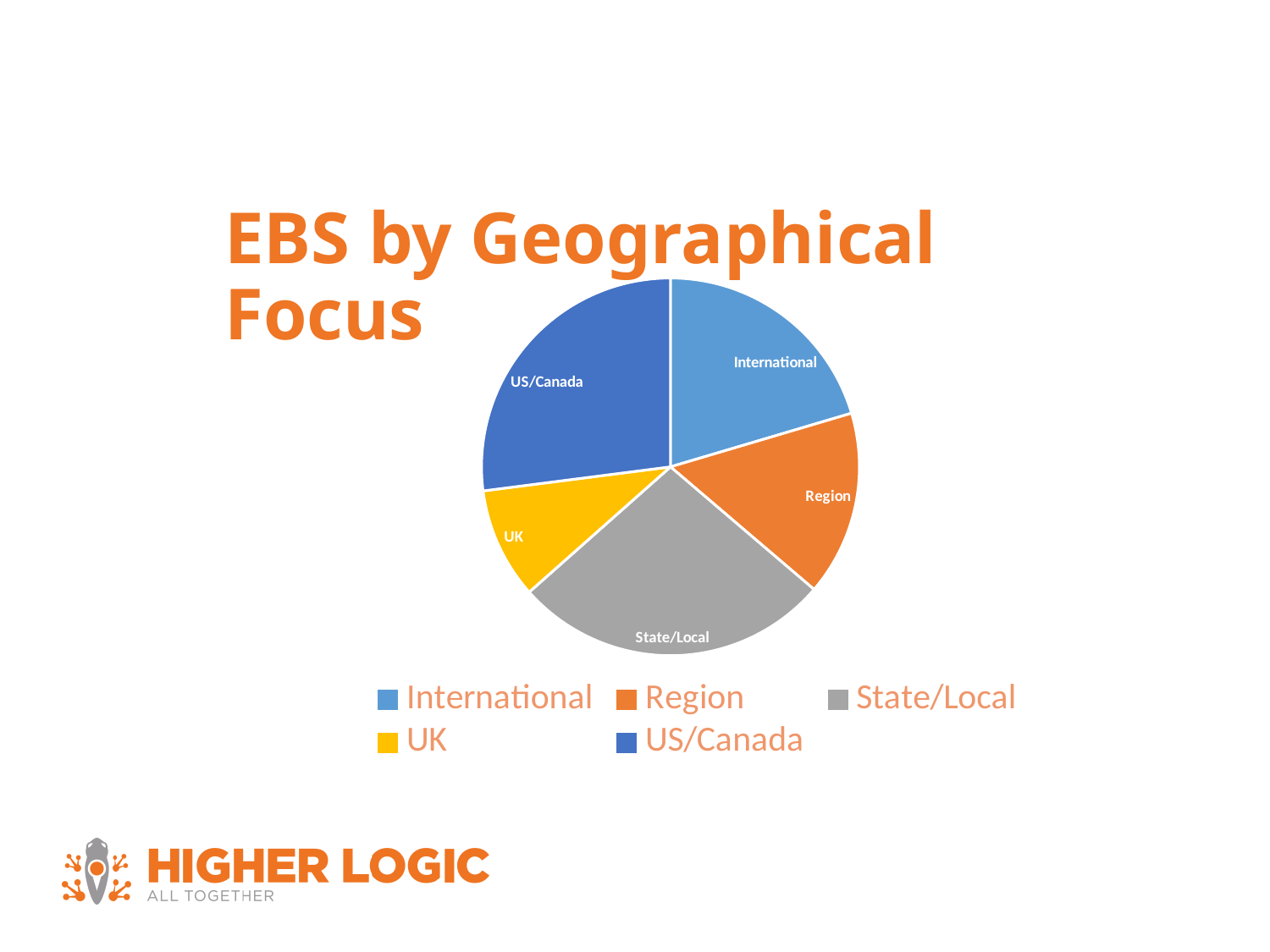
How many slices does the pie chart have? 5 Which category has the smallest slice of the pie? UK Which slice is larger, International or UK? International Which slice is larger, State/Local or Region? State/Local What colour is the State/Local slice? Grey What is the title of the chart? EBS by Geographical Focus What kind of chart is shown on the slide? Pie chart How many entries does the legend list? 5 Which slice is larger, US/Canada or UK? US/Canada